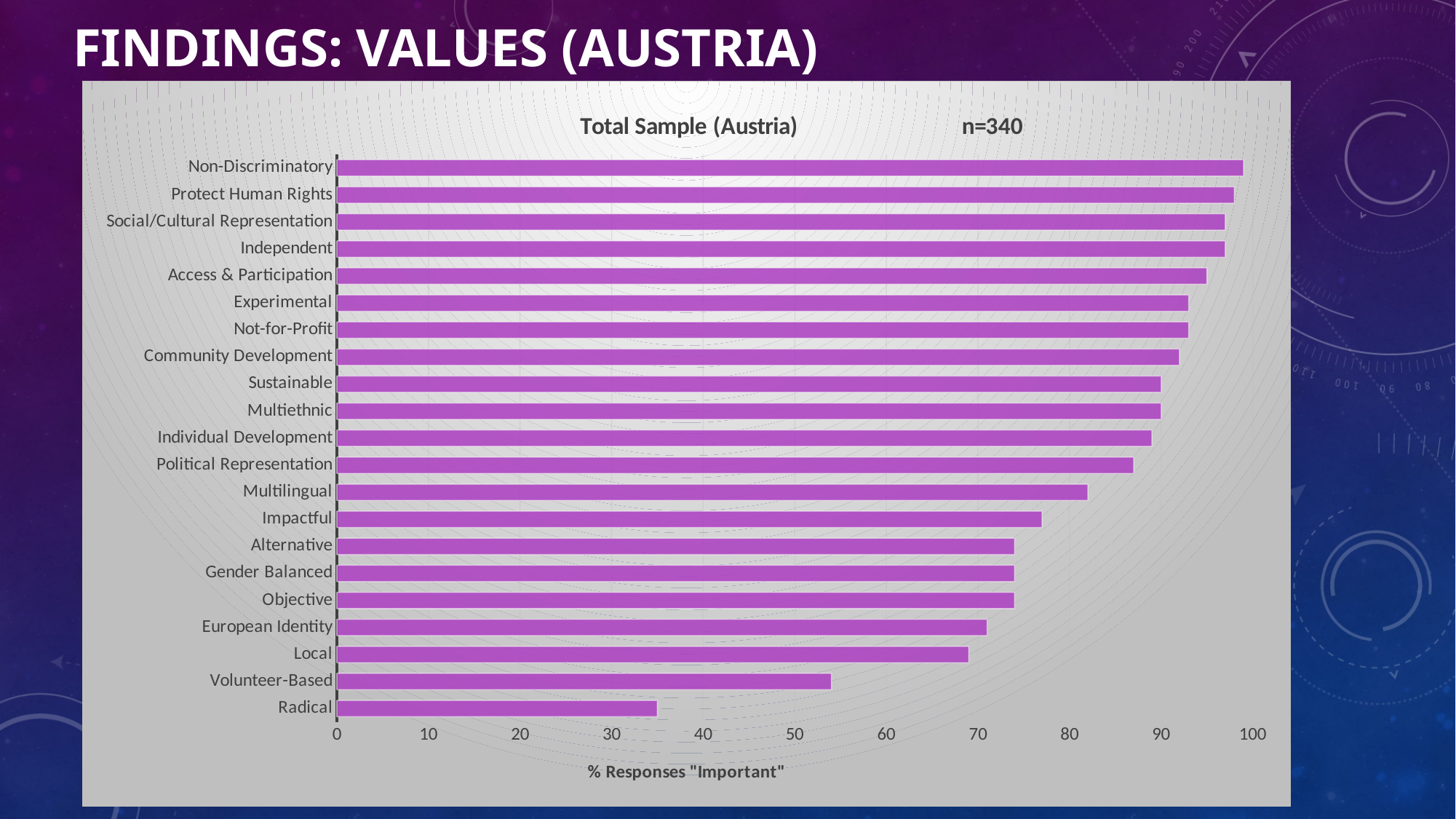
Which has the larger value, Impactful or Multilingual? Multilingual Is the value for Non-Discriminatory greater or less than 90? greater What is the title of the chart? Total Sample (Austria) Is the value for Local greater or less than 60? greater Which has the larger value, Radical or Volunteer-Based? Volunteer-Based What kind of chart is shown on the slide? Bar chart What is the sample size (n) shown on the chart? n=340 Is the value for Impactful greater or less than 70? greater How many categories (values) are plotted in the chart? 21 Which category has the lowest value in the chart? Radical